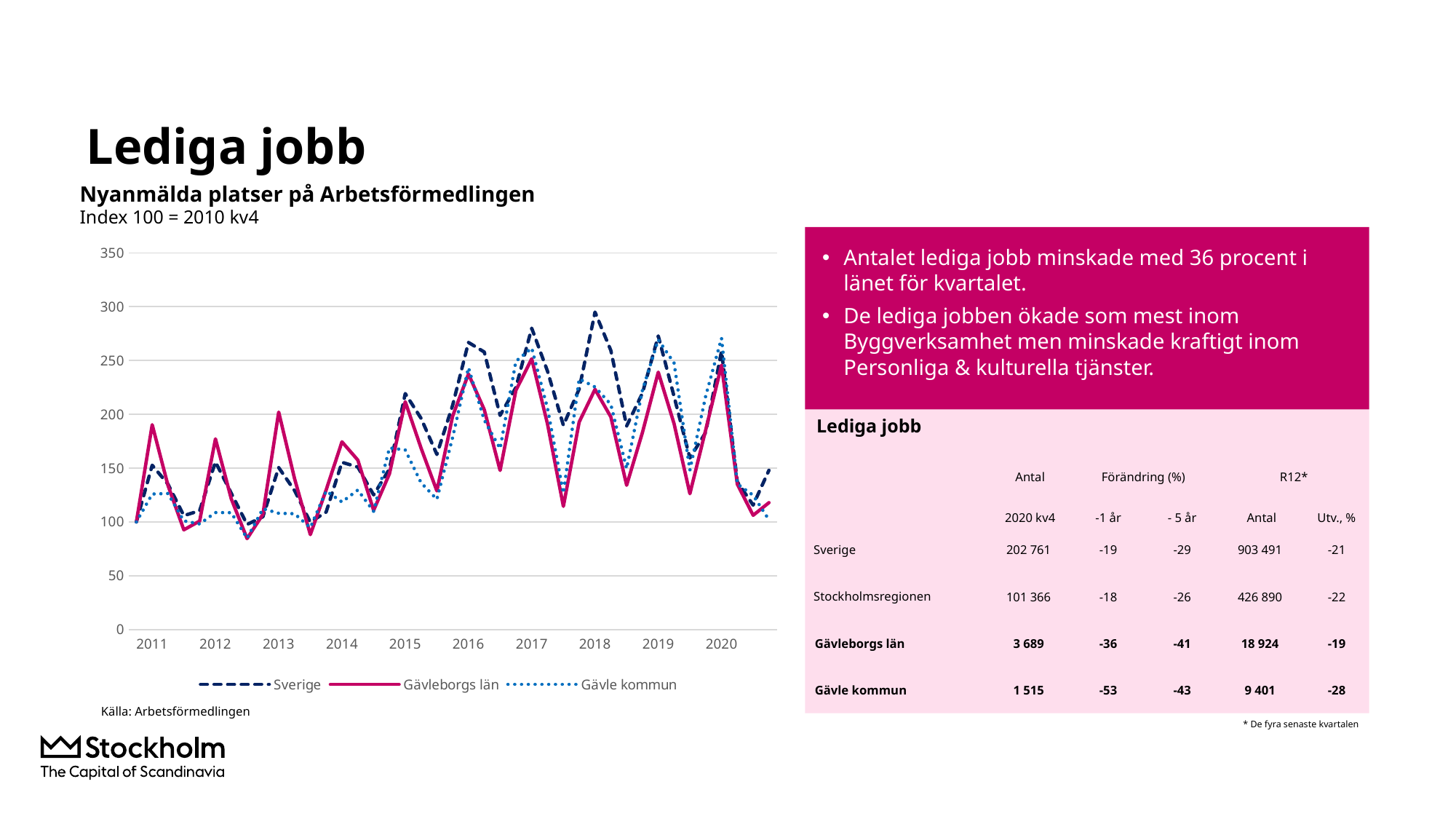
Is the peak value for Sverige in 2018 greater or less than 250? greater What is the subtitle of the chart above the plot area? Nyanmälda platser på Arbetsförmedlingen How many series does the chart legend list? 3 Is the value for Gävle kommun in 2012 greater or less than 150? less Is the lowest value for Gävleborgs län around 2013–2014 greater or less than 100? less Which series reaches the highest value anywhere on the chart? Sverige At the last point on the chart (end of 2020), which is higher, Sverige or Gävle kommun? Sverige How many year labels are shown on the x axis of the chart? 10 Which series are listed in the chart legend? Sverige, Gävleborgs län, Gävle kommun What kind of chart is shown on the slide? Line chart Do the peak values of the series generally rise or fall from 2011 to 2017? rise